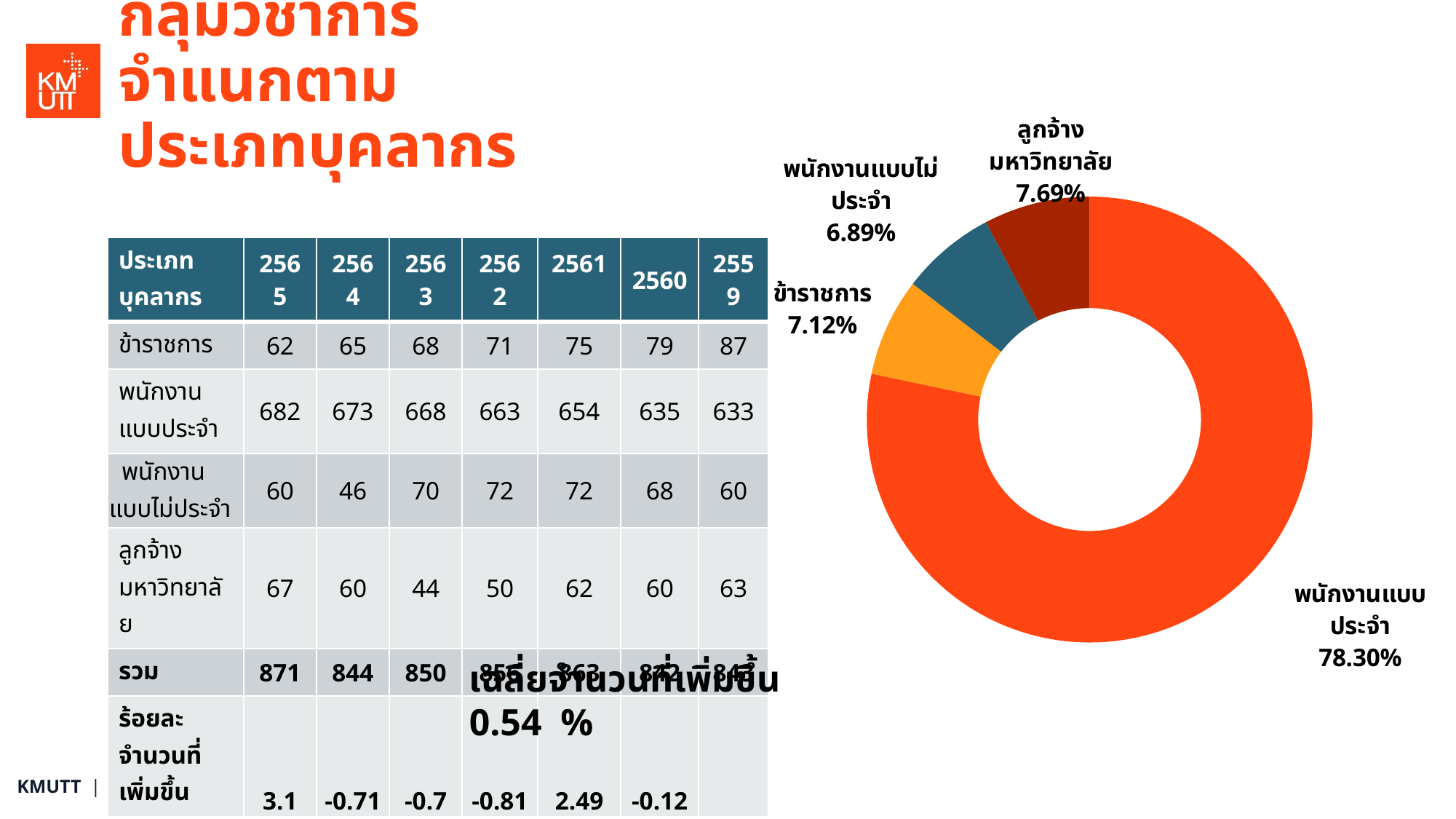
Which category has the smallest slice in the doughnut chart? พนักงานแบบไม่ประจำ In the doughnut chart, what share is shown for ลูกจ้างมหาวิทยาลัย? 7.69% In the doughnut chart, what share is shown for พนักงานแบบประจำ? 78.30% In the doughnut chart, what share is shown for พนักงานแบบไม่ประจำ? 6.89% In the doughnut chart, which is larger: the share for ข้าราชการ or the share for พนักงานแบบไม่ประจำ? ข้าราชการ What kind of chart is shown on the right side of the slide? doughnut (pie) chart In the doughnut chart, what is the difference between the share for ลูกจ้างมหาวิทยาลัย and the share for ข้าราชการ? 0.57% In the doughnut chart, what share is shown for ข้าราชการ? 7.12% Which category has the largest slice in the doughnut chart? พนักงานแบบประจำ In the doughnut chart, what is the difference between the share for พนักงานแบบประจำ and the share for ลูกจ้างมหาวิทยาลัย? 70.61% What colour is the slice for พนักงานแบบประจำ in the doughnut chart? orange-red How many categories are shown in the doughnut chart? 4